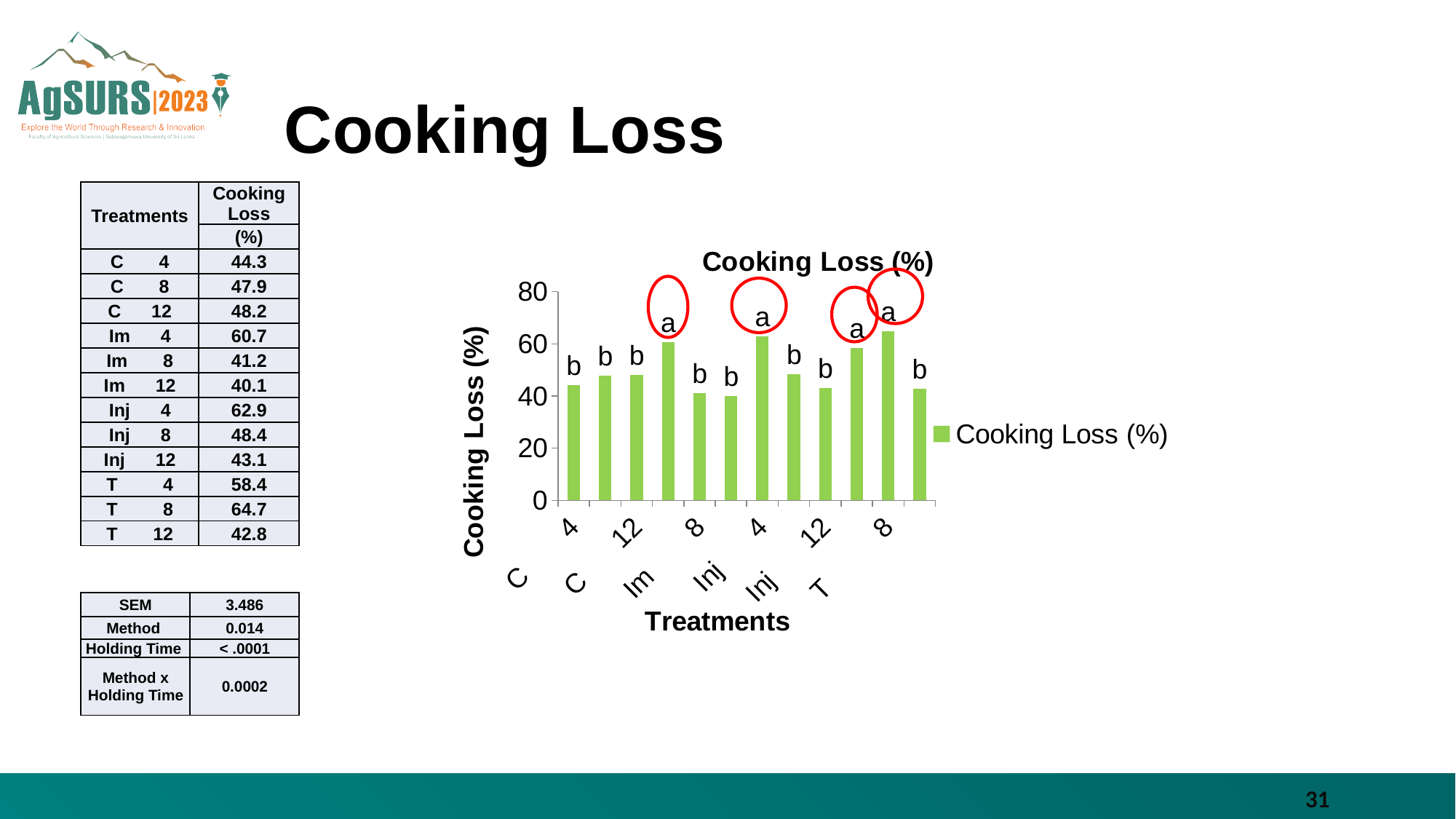
Which has the larger cooking loss (%), Im 4 or Inj 4? Inj 4 What is the cooking loss (%) for treatment Im 4? 60.7 Which treatment has the highest cooking loss (%)? T 8 What type of chart is shown on the slide? bar chart How many series does the legend of the chart list? 1 Is the value for the first bar (C 4) greater or less than 60? less What is the title of the chart? Cooking Loss (%) Is the value for Inj 4 greater or less than 60? greater Which treatment has the lowest cooking loss (%)? Im 12 What is the difference in cooking loss (%) between T 8 and T 12? 21.9 What is the cooking loss (%) for treatment T 8? 64.7 How many bars are plotted in the Cooking Loss (%) chart? 12